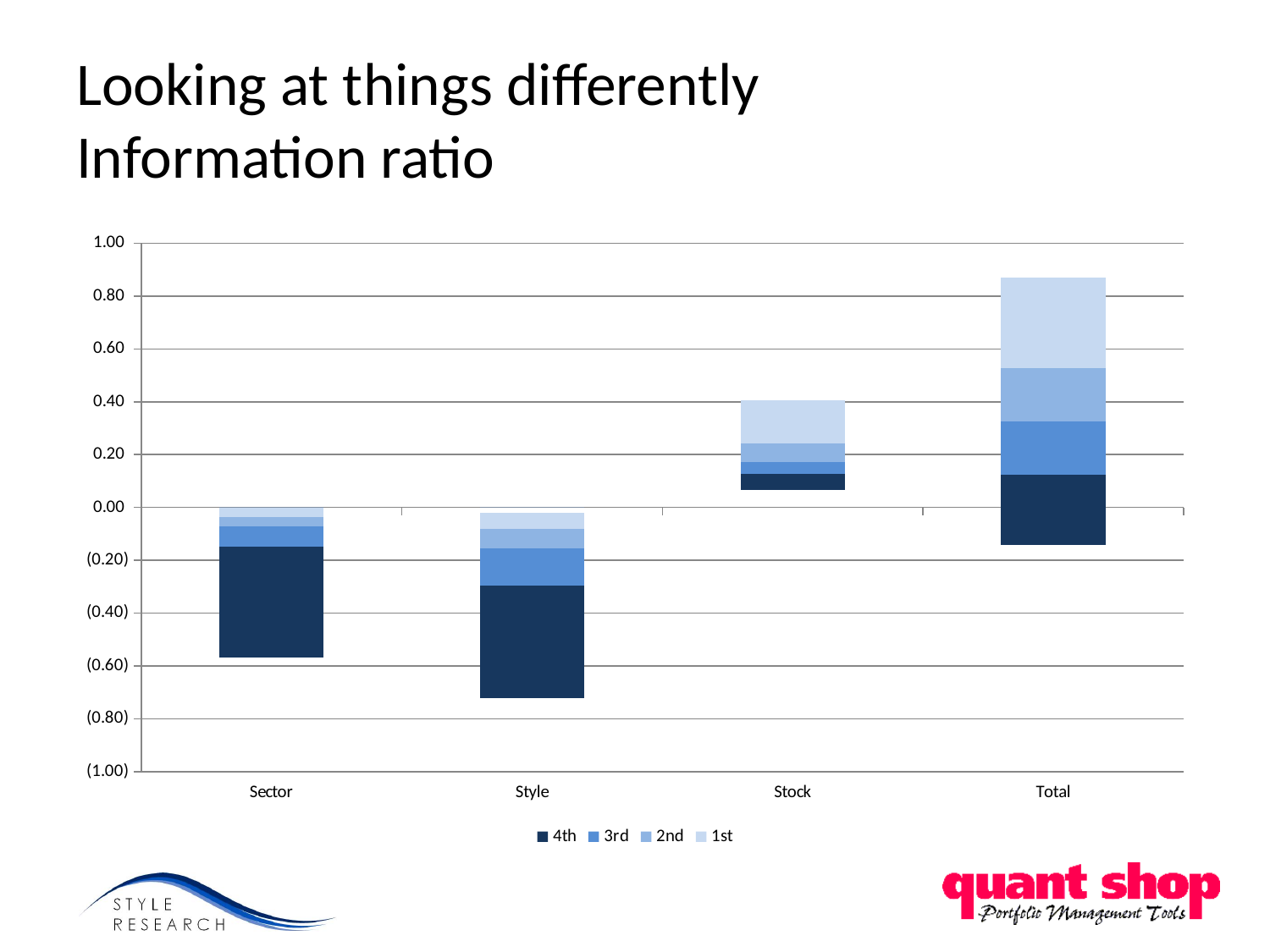
Is the bottom of the Sector bar greater or less than (0.40)? less How many series does the chart's legend list? 4 How many categories are shown on the x axis of the chart? 4 What kind of chart is shown on the slide? stacked bar chart Is the top of the Stock bar greater or less than 0.20? greater Which category's bar reaches the highest value on the chart? Total Which category's bar extends to the lowest (most negative) value on the chart? Style What is the highest value shown on the chart's vertical axis? 1.00 Is the bottom of the Style bar greater or less than (0.60)? less Which bar reaches higher, Stock or Total? Total What are the series names listed in the chart's legend? 4th, 3rd, 2nd, 1st